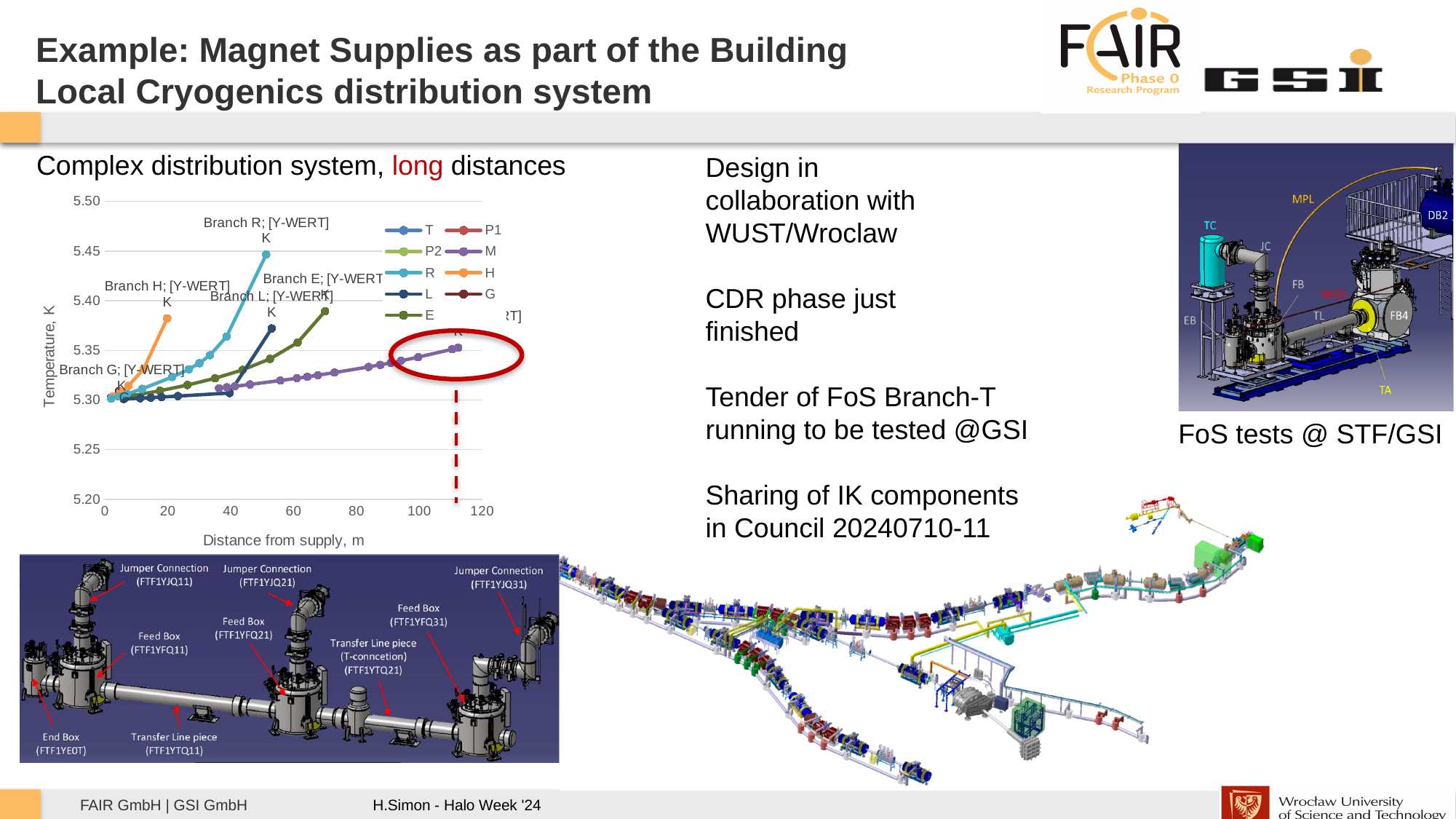
Is the final temperature of Branch L greater or less than 5.35 K? greater Which branch extends to the greatest distance from supply in the chart? Branch M What is the highest value shown on the temperature axis? 5.50 What is the label of the vertical axis of the chart? Temperature, K Is the final temperature of Branch R greater or less than 5.40 K? greater Which branch reaches the highest temperature in the chart? Branch R Is the temperature of Branch M at 60 m greater or less than 5.35 K? less What is the label of the horizontal axis of the chart? Distance from supply, m What kind of chart is shown on the slide? line chart Which reaches a higher final temperature, Branch R or Branch H? Branch R Does the temperature rise or fall with increasing distance from supply along each branch? rise